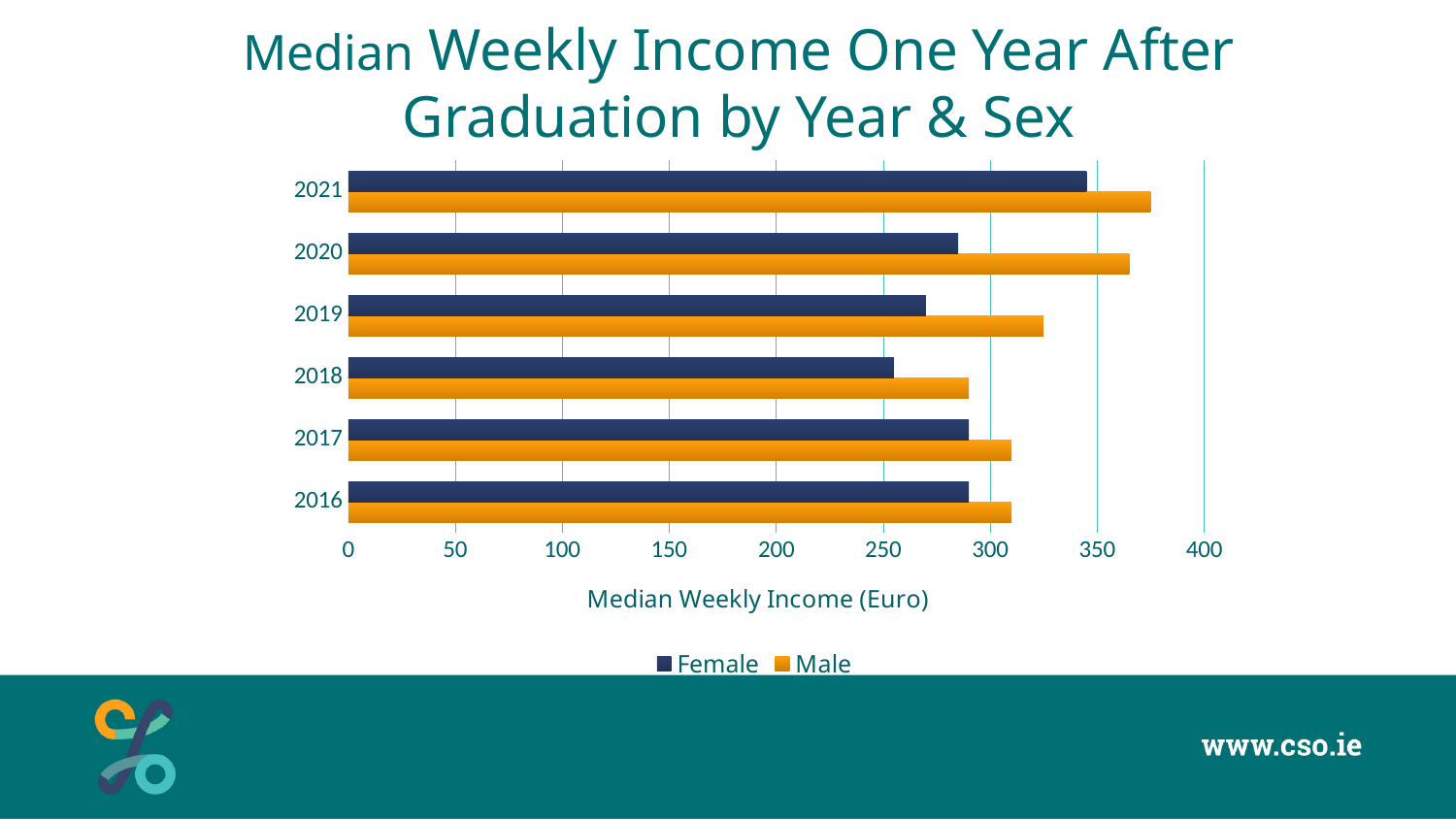
In 2020, which is larger: the median weekly income for Male or Female graduates? Male Which year has the highest median weekly income for Female graduates? 2021 Does the median weekly income for Female graduates rise or fall from 2018 to 2021? rise What is the label on the horizontal axis of the chart? Median Weekly Income (Euro) Which year has the highest median weekly income for Male graduates? 2021 What kind of chart is shown on the slide? bar chart Is the median weekly income for Male graduates in 2021 greater or less than 350? greater How many years are shown on the chart? 6 Which year has the lowest median weekly income for Female graduates? 2018 Is the median weekly income for Female graduates in 2020 greater or less than 300? less Is the median weekly income for Male graduates in 2019 greater or less than 300? greater How many series does the legend list? 2